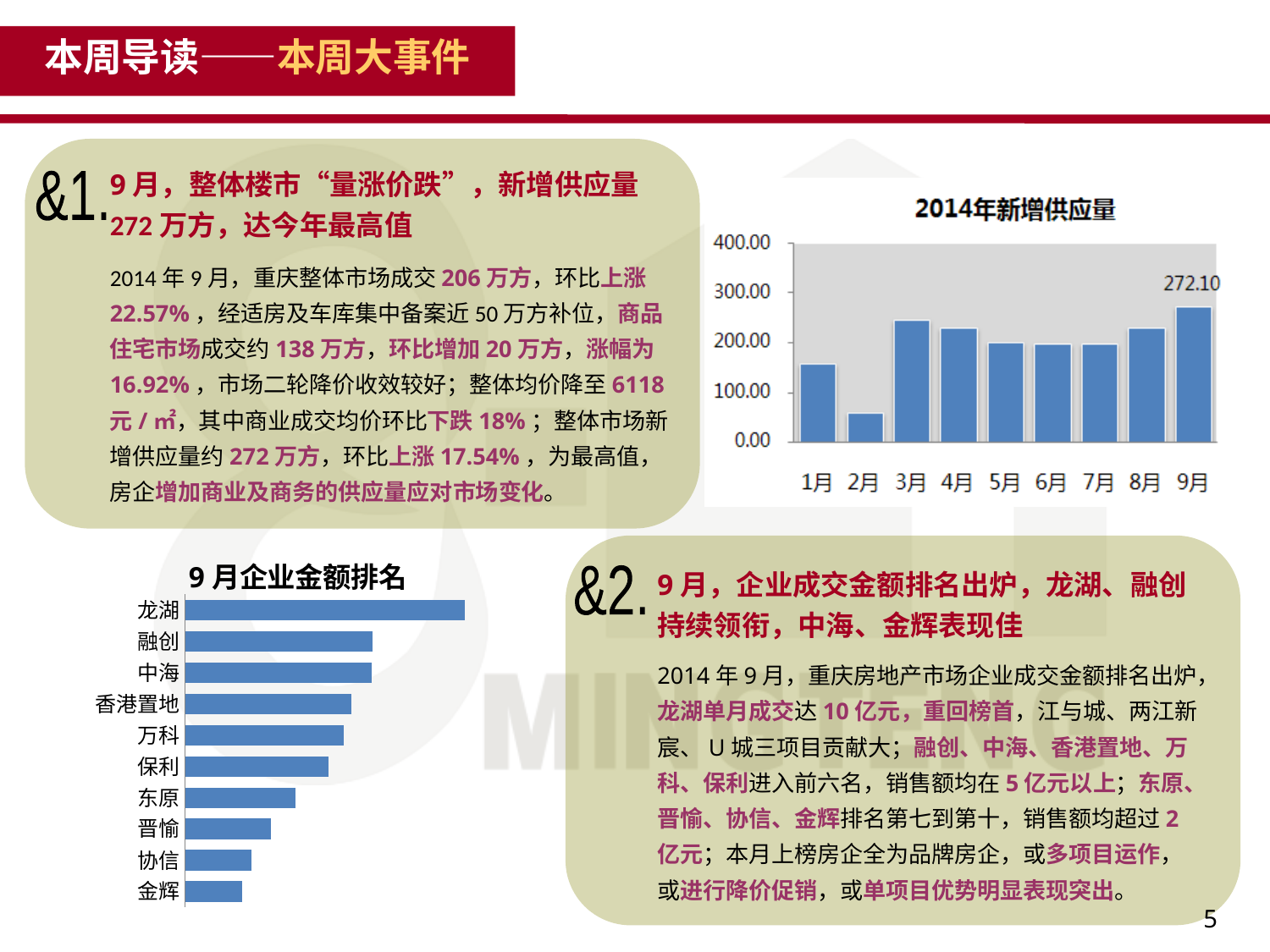
How many companies are listed in the chart titled 9月企业金额排名? 10 In the chart titled 2014年新增供应量, which month has the highest value? 9月 In the chart titled 2014年新增供应量, is the value for 3月 greater or less than 200.00? greater In the chart titled 2014年新增供应量, which is larger, the value for 1月 or the value for 2月? 1月 In the chart titled 2014年新增供应量, what is the value for 9月? 272.10 In the chart titled 9月企业金额排名, which company has the shortest bar? 金辉 In the chart titled 2014年新增供应量, which month has the lowest value? 2月 In the chart titled 2014年新增供应量, is the value for 2月 greater or less than 100.00? less In the chart titled 9月企业金额排名, which company has the longest bar? 龙湖 What kind of chart is the chart titled 9月企业金额排名? bar chart What kind of chart is the chart titled 2014年新增供应量? bar chart How many months are plotted in the chart titled 2014年新增供应量? 9